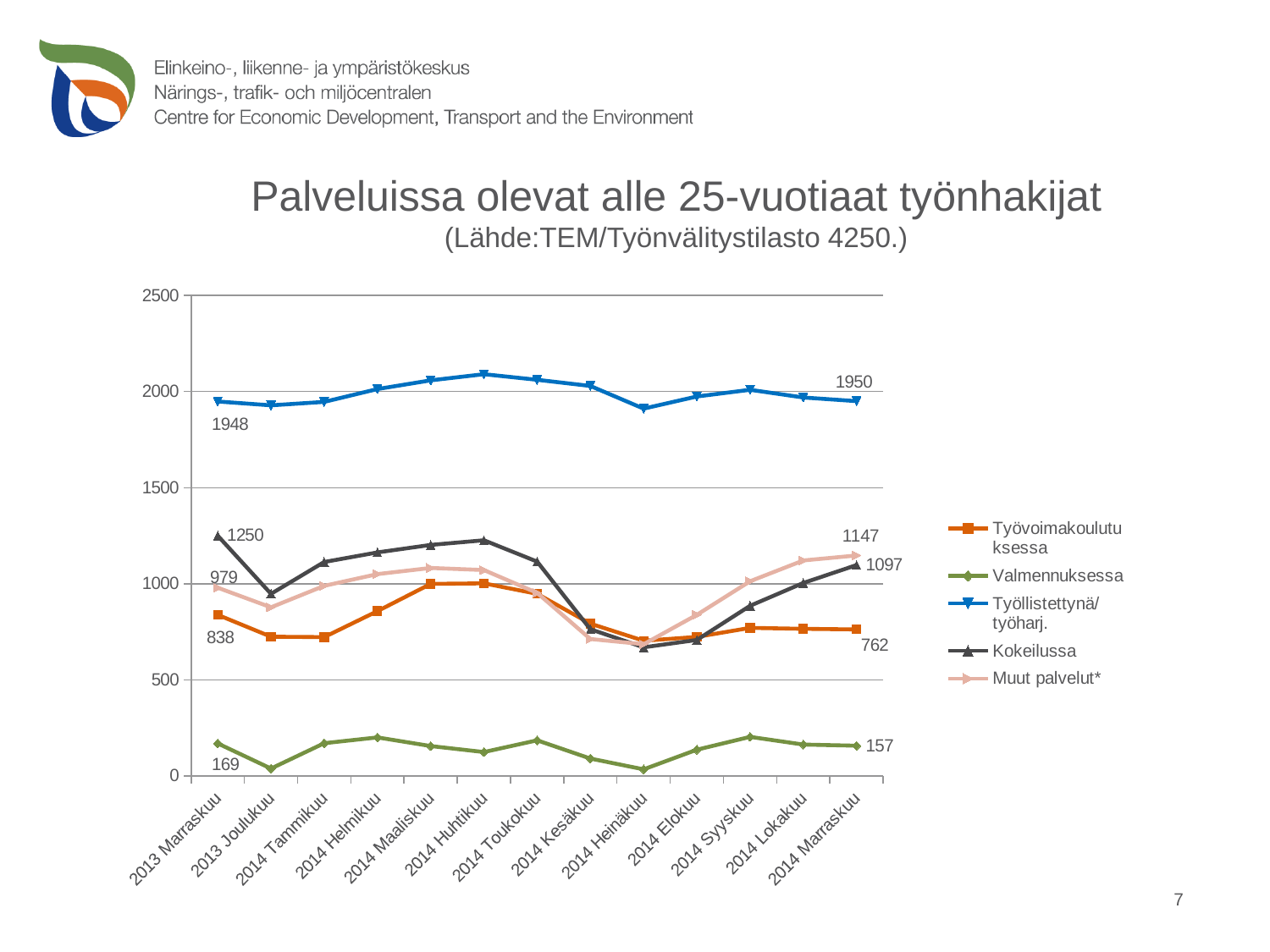
How many series does the legend list? 5 What is the value for Kokeilussa in 2013 Marraskuu? 1250 What type of chart is shown on the slide? line chart What is the difference between the Työvoimakoulutuksessa values in 2013 Marraskuu and 2014 Marraskuu? 76 Is the value for Kokeilussa in 2014 Heinäkuu greater or less than 1000? less What is the value for Työllistettynä/työharj. in 2014 Marraskuu? 1950 How many months are shown on the x axis? 13 Which series has the highest value in 2014 Marraskuu? Työllistettynä/työharj. What is the value for Valmennuksessa in 2014 Marraskuu? 157 What is the value for Työllistettynä/työharj. in 2013 Marraskuu? 1948 Which series has the lowest value in 2013 Marraskuu? Valmennuksessa What is the value for Muut palvelut* in 2014 Marraskuu? 1147